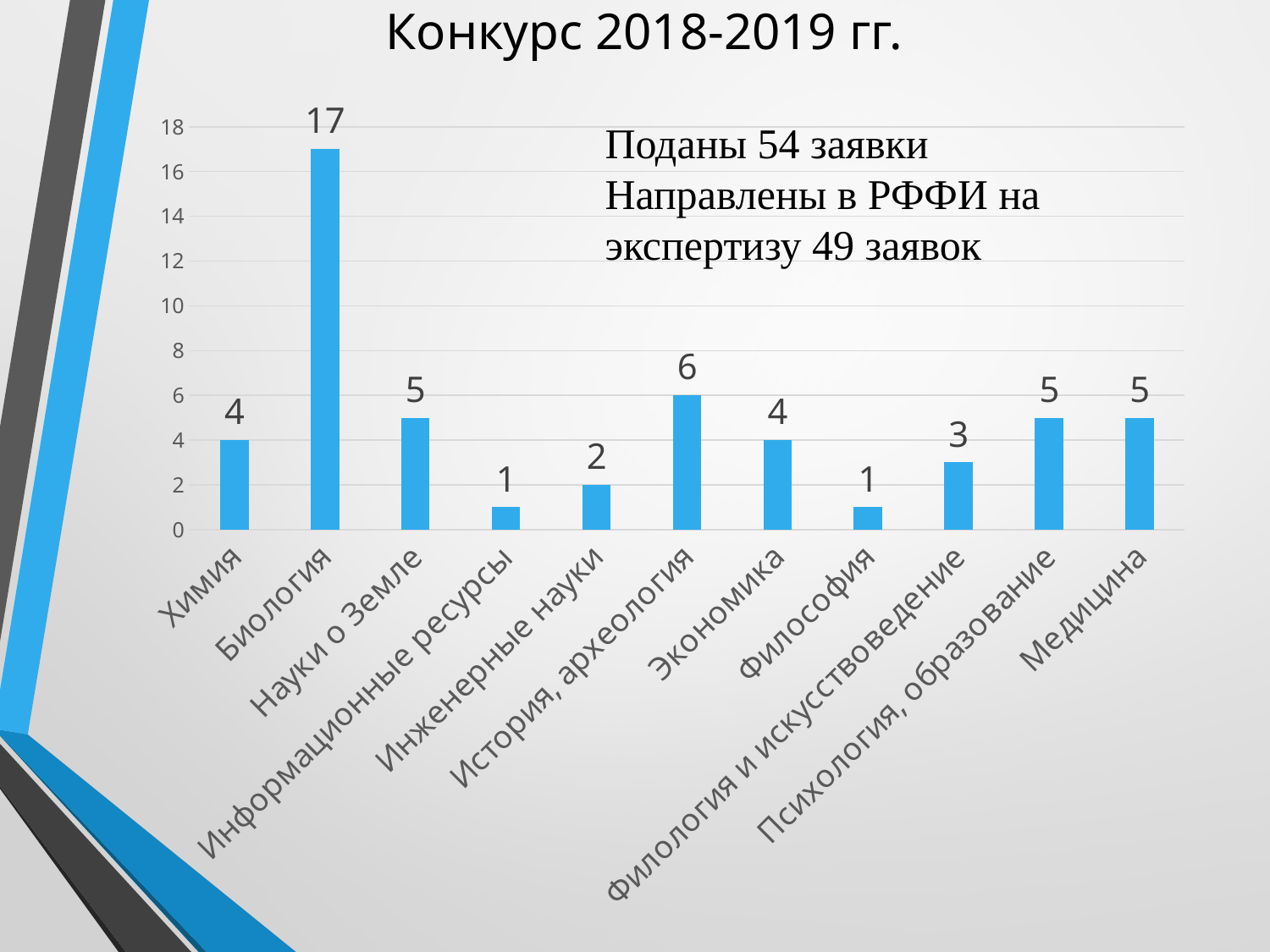
Which category has the highest value? Биология What kind of chart is shown on the slide? bar chart What is the value for Биология? 17 What is the value for Инженерные науки? 2 What is the difference between the values for Биология and История, археология? 11 How many categories are shown on the x axis? 11 What is the title of the slide? Конкурс 2018-2019 гг. What is the value for Филология и искусствоведение? 3 What is the value for История, археология? 6 What is the difference between the values for Науки о Земле and Философия? 4 Is the value for Биология greater or less than 10? greater Which is larger, the value for Экономика or the value for Медицина? Медицина